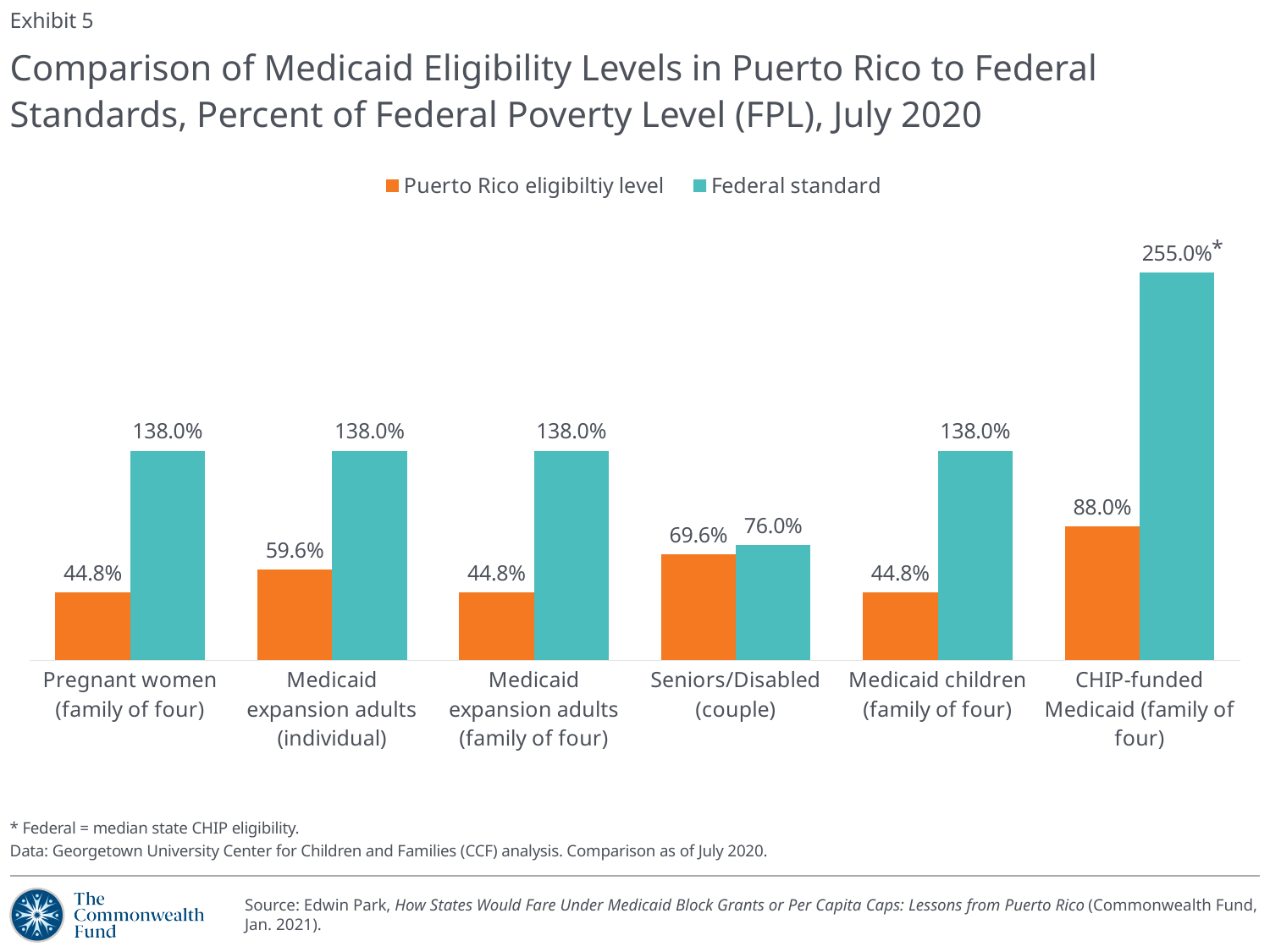
Which category has the highest Federal standard? CHIP-funded Medicaid (family of four) How many series does the legend list? 2 Which is larger for CHIP-funded Medicaid (family of four): the Puerto Rico eligibility level or the Federal standard? Federal standard What is the Puerto Rico eligibility level for Pregnant women (family of four)? 44.8% What is the Puerto Rico eligibility level for Medicaid expansion adults (individual)? 59.6% Which category has the lowest Federal standard? Seniors/Disabled (couple) What is the Puerto Rico eligibility level for Seniors/Disabled (couple)? 69.6% What is the difference between the Federal standard and the Puerto Rico eligibility level for Seniors/Disabled (couple)? 6.4% What is the difference between the Federal standard and the Puerto Rico eligibility level for Medicaid children (family of four)? 93.2% What is the Federal standard for CHIP-funded Medicaid (family of four)? 255.0% What kind of chart is shown on the slide? Bar chart How many categories are shown on the x axis? 6